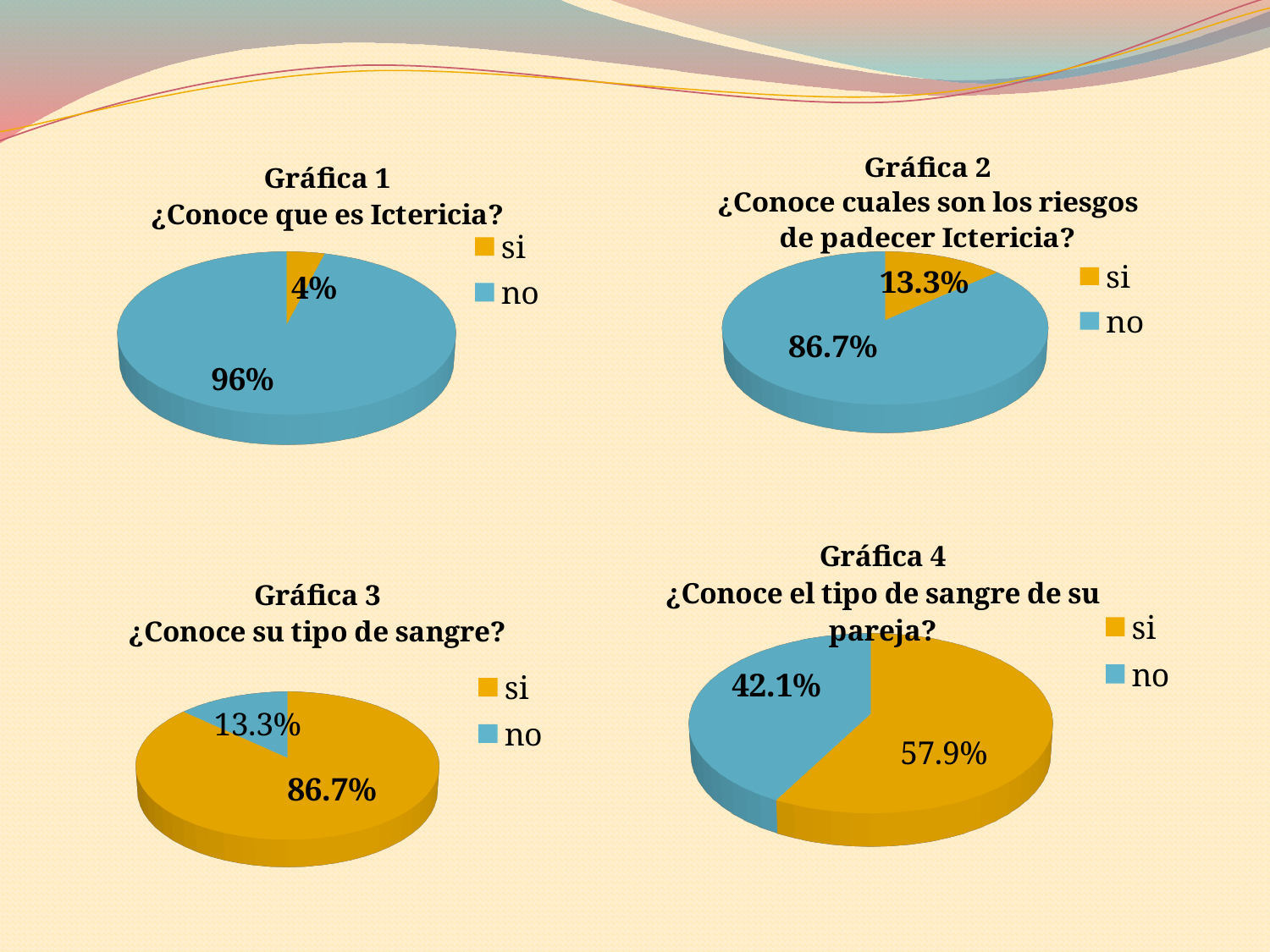
In Gráfica 4 (¿Conoce el tipo de sangre de su pareja?), which is larger, the "si" slice or the "no" slice? si In Gráfica 3 (¿Conoce su tipo de sangre?), which answer has the smallest slice? no How many entries does the legend of Gráfica 2 (¿Conoce cuales son los riesgos de padecer Ictericia?) list? 2 In Gráfica 4 (¿Conoce el tipo de sangre de su pareja?), what is the difference between the "si" and "no" percentages? 15.8% In Gráfica 2 (¿Conoce cuales son los riesgos de padecer Ictericia?), which answer has the largest slice? no In Gráfica 3 (¿Conoce su tipo de sangre?), what percentage answered "si"? 86.7% In Gráfica 4 (¿Conoce el tipo de sangre de su pareja?), what percentage answered "no"? 42.1% In Gráfica 1 (¿Conoce que es Ictericia?), what percentage answered "no"? 96% What kind of chart is Gráfica 3 (¿Conoce su tipo de sangre?)? pie chart In Gráfica 1 (¿Conoce que es Ictericia?), what percentage answered "si"? 4% In Gráfica 2 (¿Conoce cuales son los riesgos de padecer Ictericia?), what percentage answered "si"? 13.3% In Gráfica 1 (¿Conoce que es Ictericia?), what is the difference between the "no" and "si" percentages? 92%